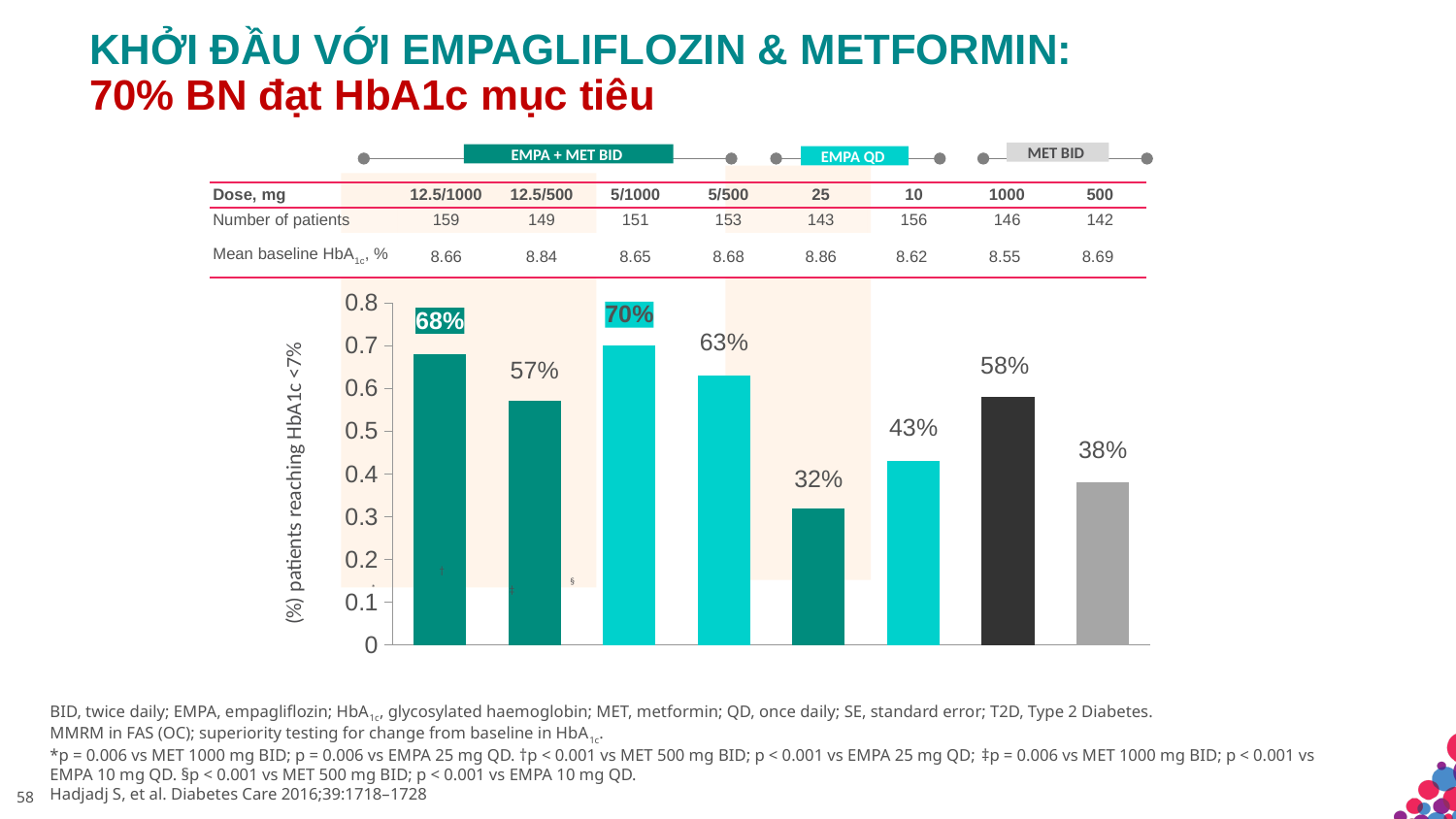
What is the difference in percentage of patients reaching HbA1c <7% between EMPA QD 10 mg and EMPA QD 25 mg? 11% Which has a higher percentage of patients reaching HbA1c <7%: EMPA QD 10 mg or MET BID 500 mg? EMPA QD 10 mg What percentage of patients reached HbA1c <7% with MET BID 1000 mg? 58% Which dose group has the lowest percentage of patients reaching HbA1c <7%? EMPA QD 25 What type of chart is used to show the percentage of patients reaching HbA1c <7%? Bar chart What is the label of the y-axis of the chart? (%) patients reaching HbA1c <7% What percentage of patients reached HbA1c <7% with EMPA + MET BID 5/1000 mg? 70% How many dose groups (bars) are shown in the chart? 8 What is the difference in percentage of patients reaching HbA1c <7% between EMPA + MET BID 12.5/1000 and MET BID 1000? 10% What percentage of patients reached HbA1c <7% with EMPA QD 25 mg? 32% Which dose group has the highest percentage of patients reaching HbA1c <7%? EMPA + MET BID 5/1000 How many patients were in the EMPA + MET BID 12.5/1000 group according to the table? 159